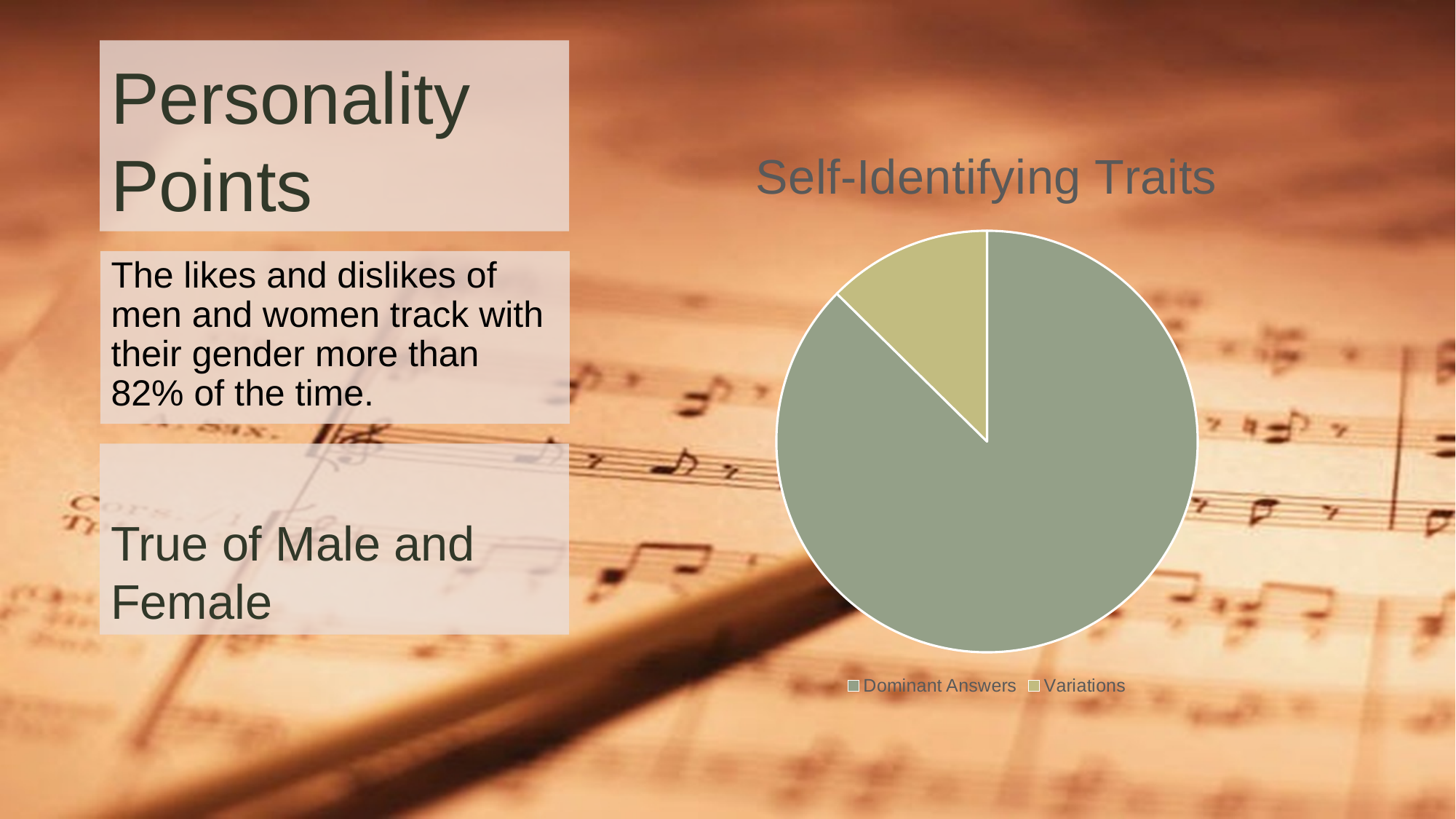
What kind of chart is shown on the slide? Pie chart How many entries does the chart legend list? 2 Which is larger in the pie chart, Dominant Answers or Variations? Dominant Answers Which slice of the pie chart is the smallest? Variations Which slice of the pie chart is the largest? Dominant Answers How many slices does the pie chart have? 2 What are the two categories listed in the chart legend? Dominant Answers and Variations What is the title of the chart? Self-Identifying Traits